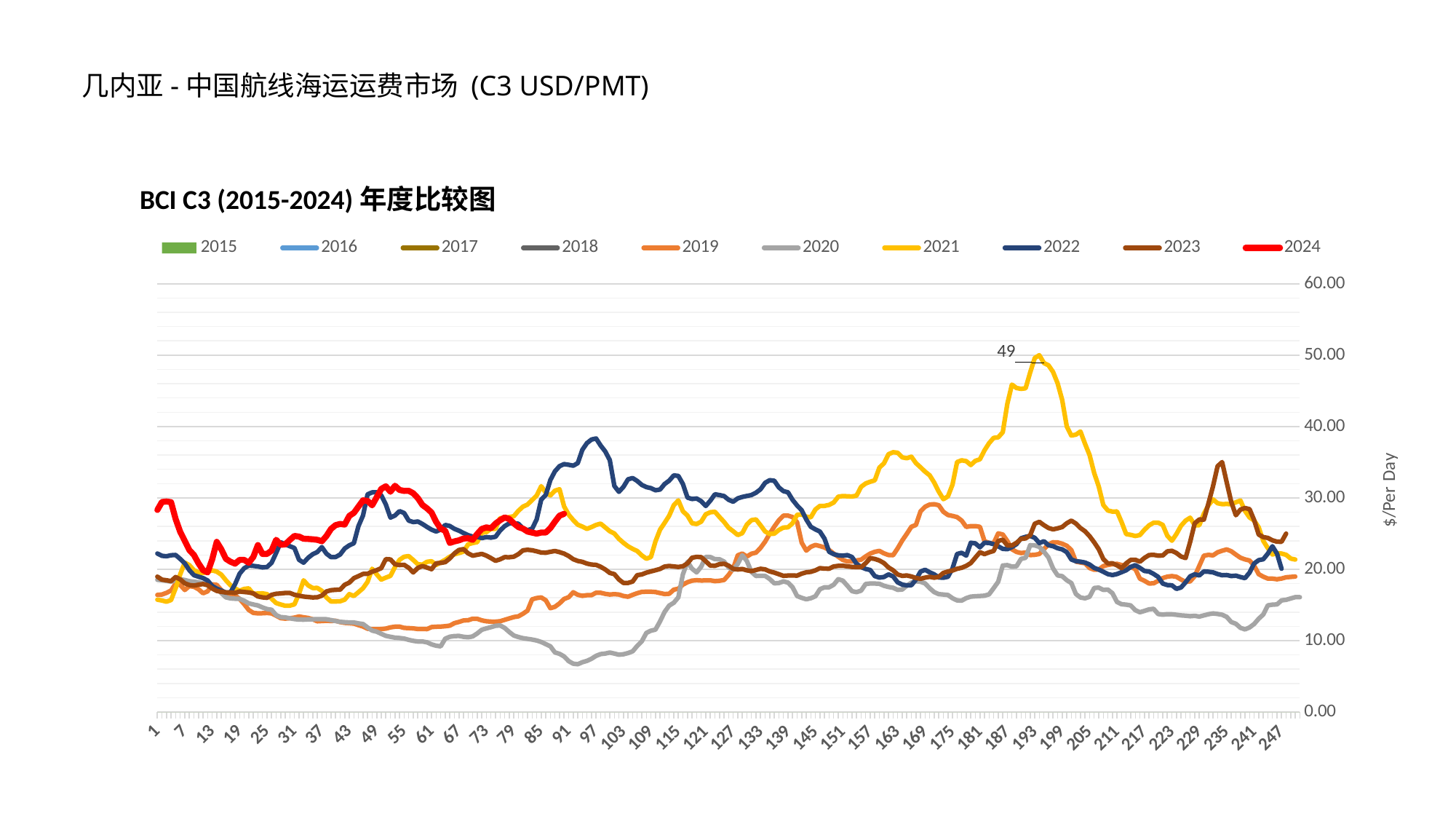
Is the value for the 2024 series at point 1 greater or less than 20.00? greater At point 1, which series has the higher value, 2024 or 2022? 2024 Which series reaches the highest value on the chart? 2021 What is the title of the chart? BCI C3 (2015-2024) 年度比较图 Does the 2024 series rise or fall between point 55 and point 67? fall Is the lowest value of the 2020 series (around point 97) greater or less than 10.00? less What is the label on the vertical axis? $/Per Day What is the labelled peak value of the 2021 series? 49 Which series reaches the lowest value on the chart? 2020 How many series does the legend list? 10 What type of chart is shown on the slide? line chart Is the peak of the 2023 series (around point 235) greater or less than 30.00? greater